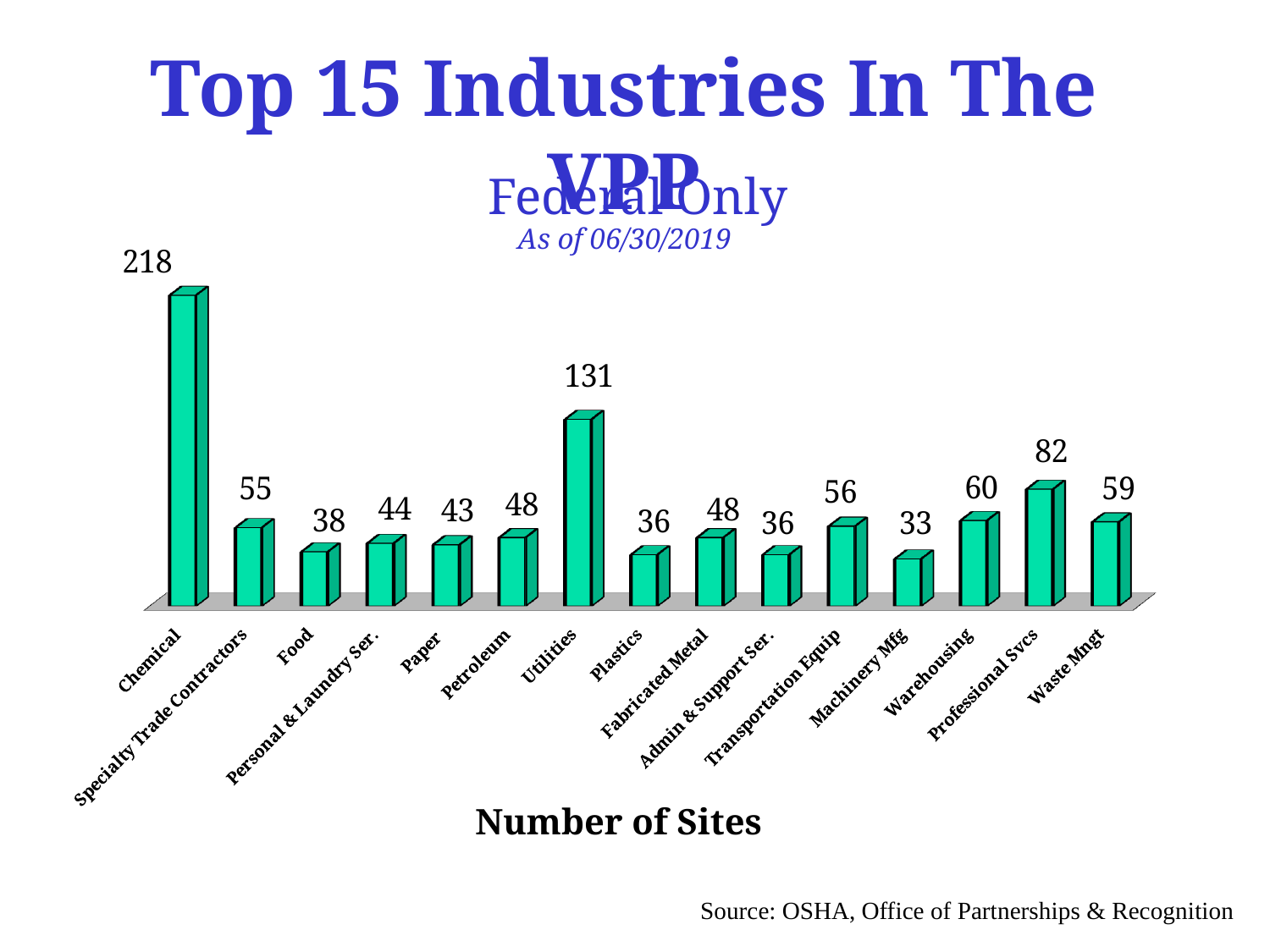
What is the number of sites for Utilities? 131 What is the x-axis label of the chart? Number of Sites How many industries are shown in the chart? 15 What is the number of sites for Chemical? 218 Which has more sites, Warehousing or Waste Mngt? Warehousing What is the difference in number of sites between Chemical and Utilities? 87 What kind of chart is shown on the slide? Bar chart What is the difference in number of sites between Professional Svcs and Machinery Mfg? 49 Which industry has the lowest number of sites? Machinery Mfg What is the number of sites for Transportation Equip? 56 What is the number of sites for Professional Svcs? 82 Which industry has the highest number of sites? Chemical